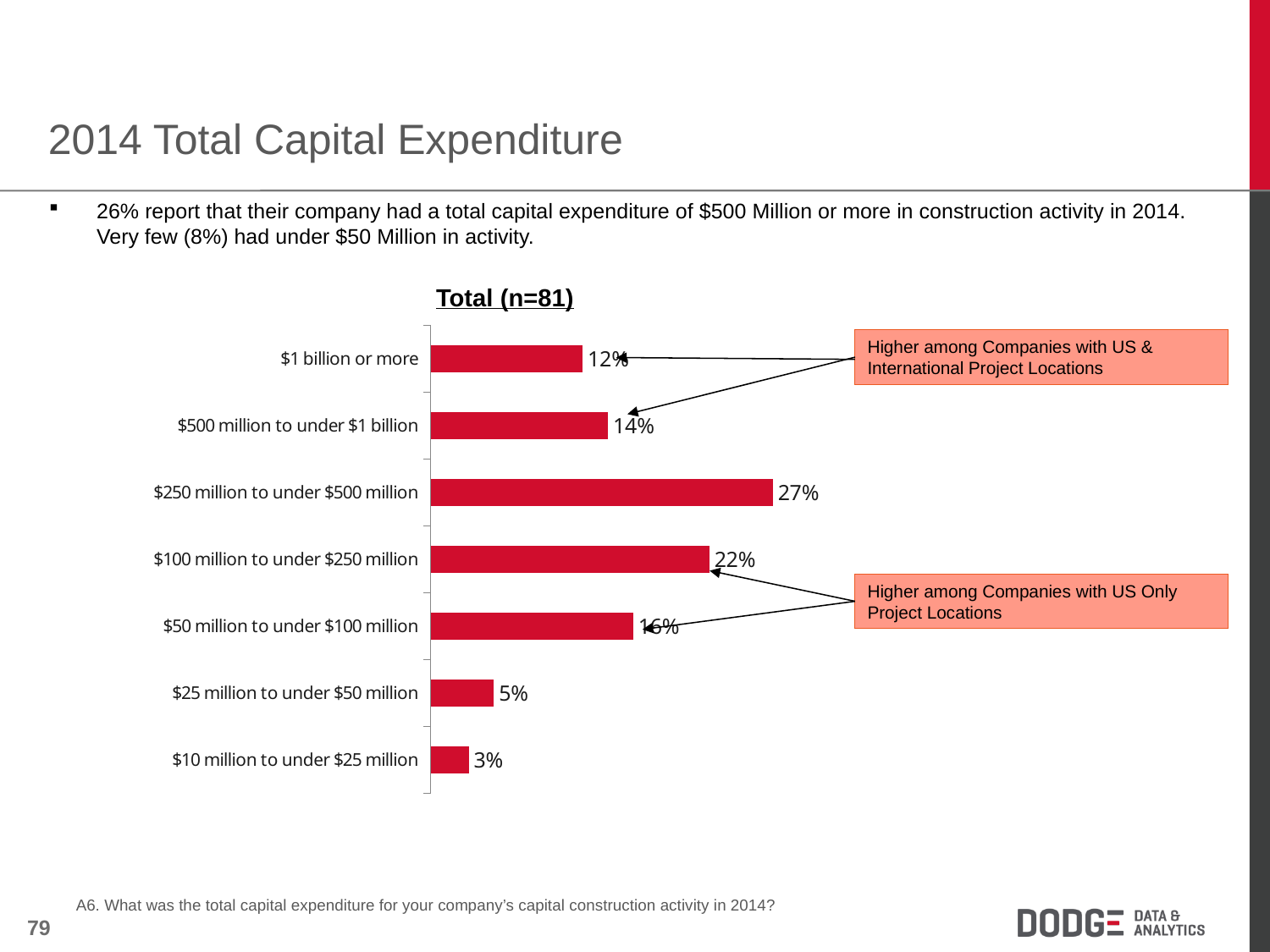
What kind of chart is shown on the slide? Bar chart What percentage of companies reported a 2014 total capital expenditure of $250 million to under $500 million? 27% Which is larger: the value for "$500 million to under $1 billion" or the value for "$1 billion or more"? $500 million to under $1 billion What is the value shown for the "$1 billion or more" category? 12% What is the difference in percentage points between "$250 million to under $500 million" and "$100 million to under $250 million"? 5 What percentage is shown for "$500 million to under $1 billion"? 14% How many capital expenditure categories are shown in the chart? 7 What is the title shown above the chart? Total (n=81) Which capital expenditure category has the highest percentage? $250 million to under $500 million What is the difference in percentage points between "$25 million to under $50 million" and "$10 million to under $25 million"? 2 What is the value for "$10 million to under $25 million"? 3% Which capital expenditure category has the lowest percentage? $10 million to under $25 million